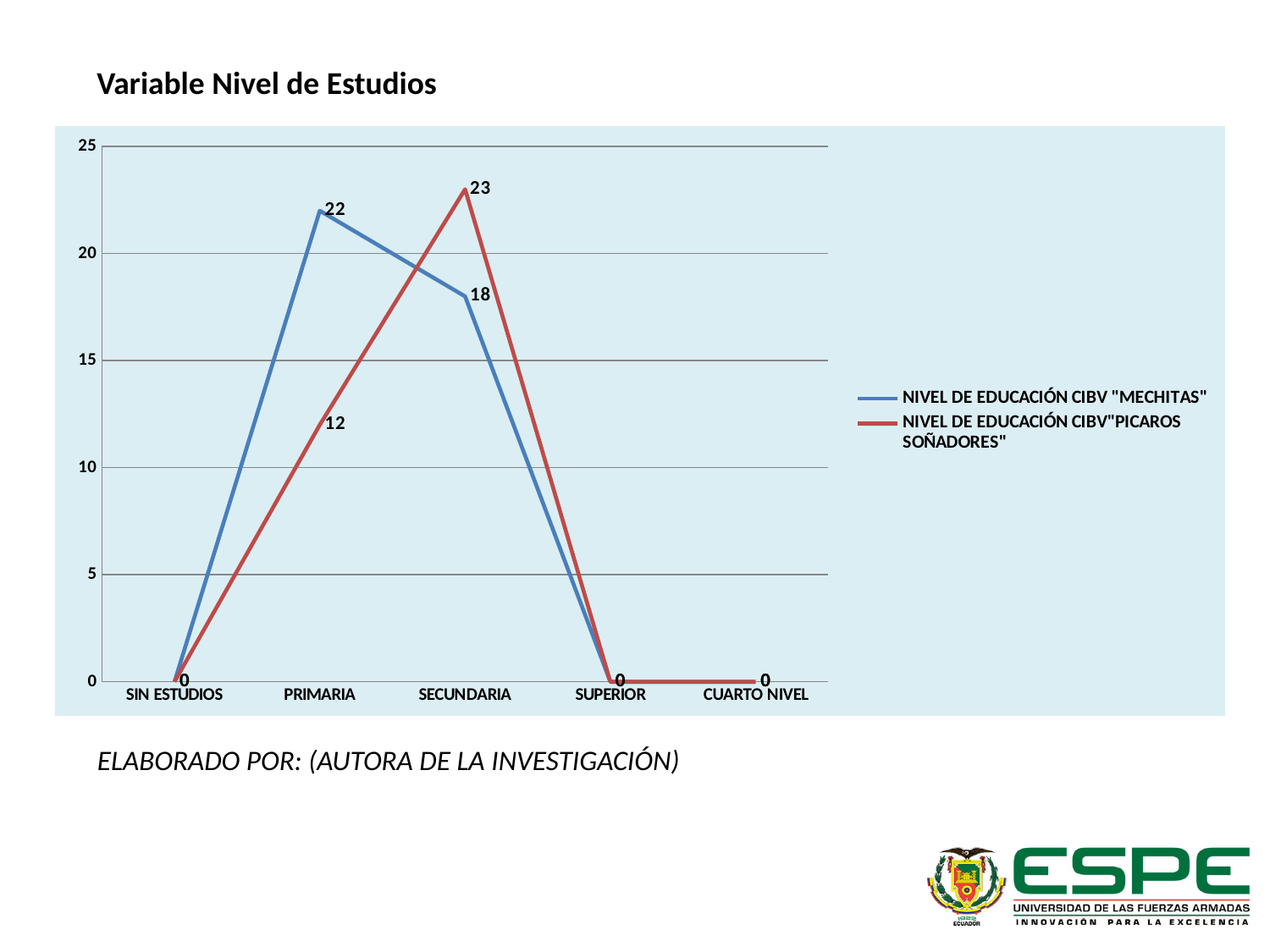
Which category has the highest value in the NIVEL DE EDUCACIÓN CIBV"PICAROS SOÑADORES" series? SECUNDARIA How many categories are shown on the x axis? 5 Which category has the highest value in the NIVEL DE EDUCACIÓN CIBV "MECHITAS" series? PRIMARIA At SECUNDARIA, which series has the larger value? NIVEL DE EDUCACIÓN CIBV"PICAROS SOÑADORES" What is the value for PRIMARIA in the NIVEL DE EDUCACIÓN CIBV "MECHITAS" series? 22 How many series does the legend list? 2 What is the difference between the two series at PRIMARIA? 10 What is the value for PRIMARIA in the NIVEL DE EDUCACIÓN CIBV"PICAROS SOÑADORES" series? 12 What is the value for SECUNDARIA in the NIVEL DE EDUCACIÓN CIBV "MECHITAS" series? 18 What is the value for SECUNDARIA in the NIVEL DE EDUCACIÓN CIBV"PICAROS SOÑADORES" series? 23 What kind of chart is shown on the slide? Line chart What is the difference between the two series at SECUNDARIA? 5